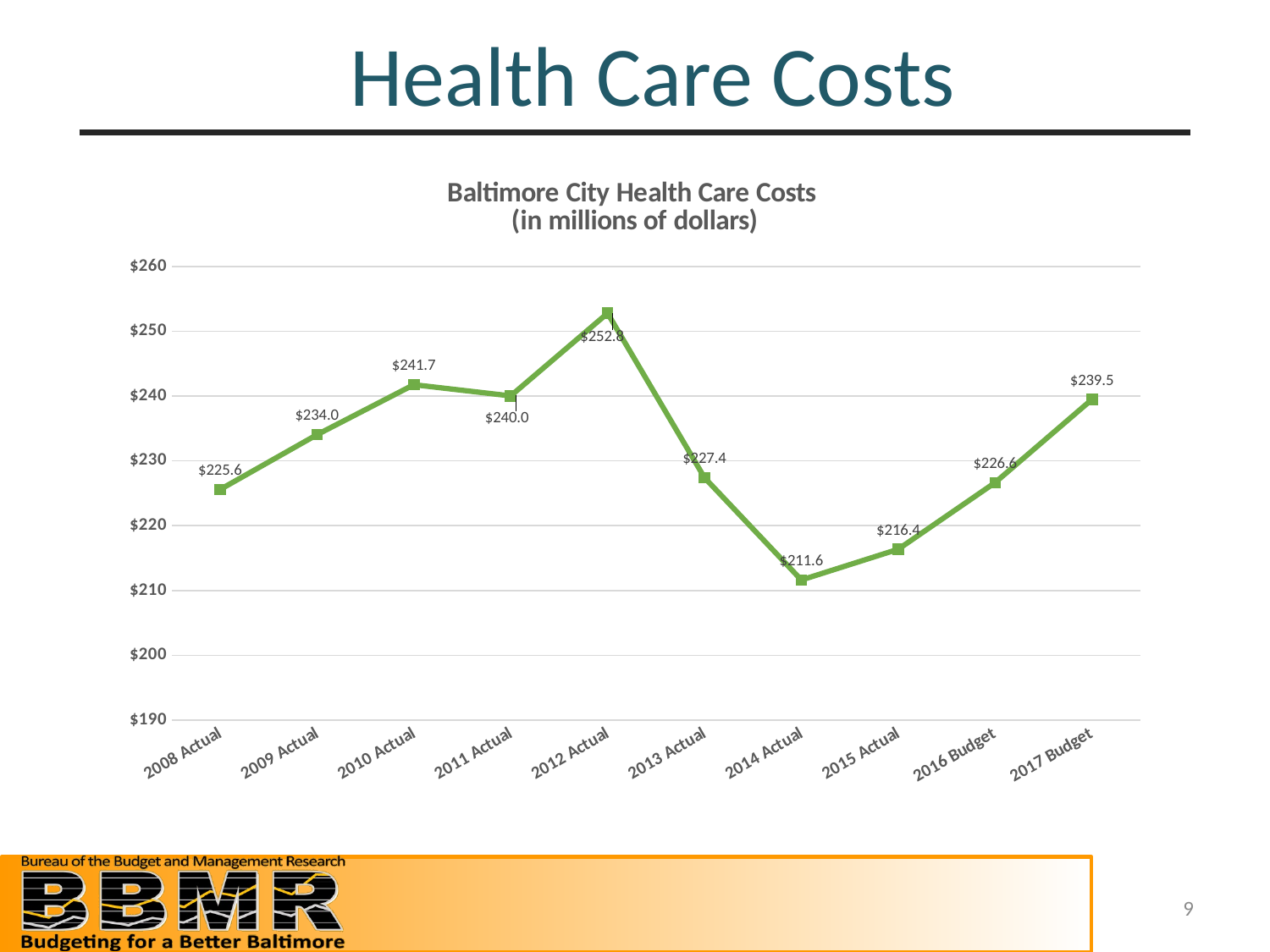
Which is larger, the value for 2010 Actual or the value for 2011 Actual? 2010 Actual What is the value for 2012 Actual? $252.8 What is the title of the chart? Baltimore City Health Care Costs (in millions of dollars) What is the value for 2014 Actual? $211.6 What kind of chart is shown? line chart Is the value for 2015 Actual greater or less than $220? less Do the values rise or fall from 2014 Actual to 2017 Budget? rise Which year has the highest health care cost? 2012 Actual What is the difference between the 2012 Actual and 2014 Actual values? $41.2 How many data points are plotted on the chart? 10 Which year has the lowest health care cost? 2014 Actual What is the value for 2017 Budget? $239.5